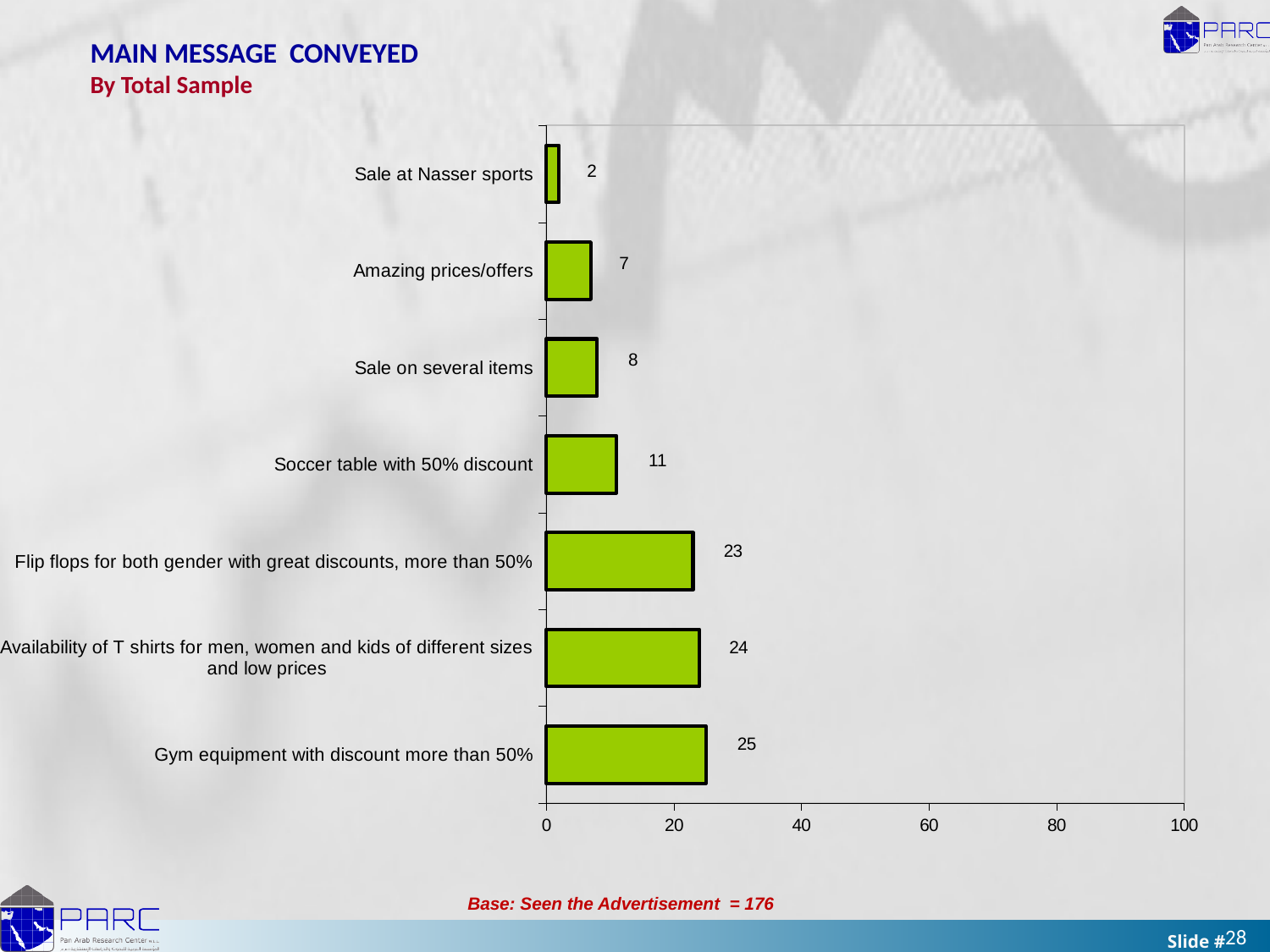
What is the value for Gym equipment with discount more than 50%? 25 What is the value for Amazing prices/offers? 7 What is the base stated below the chart? Seen the Advertisement = 176 What kind of chart is shown on the slide? Bar chart What is the difference between the values for Flip flops for both gender with great discounts, more than 50% and Sale on several items? 15 Which category has the lowest value? Sale at Nasser sports What is the value for Sale at Nasser sports? 2 Is the value for Availability of T shirts for men, women and kids of different sizes and low prices greater or less than 20? greater Which category has the highest value? Gym equipment with discount more than 50% How many categories are shown in the chart? 7 Which is larger: the value for Sale on several items or the value for Amazing prices/offers? Sale on several items What is the value for Soccer table with 50% discount? 11